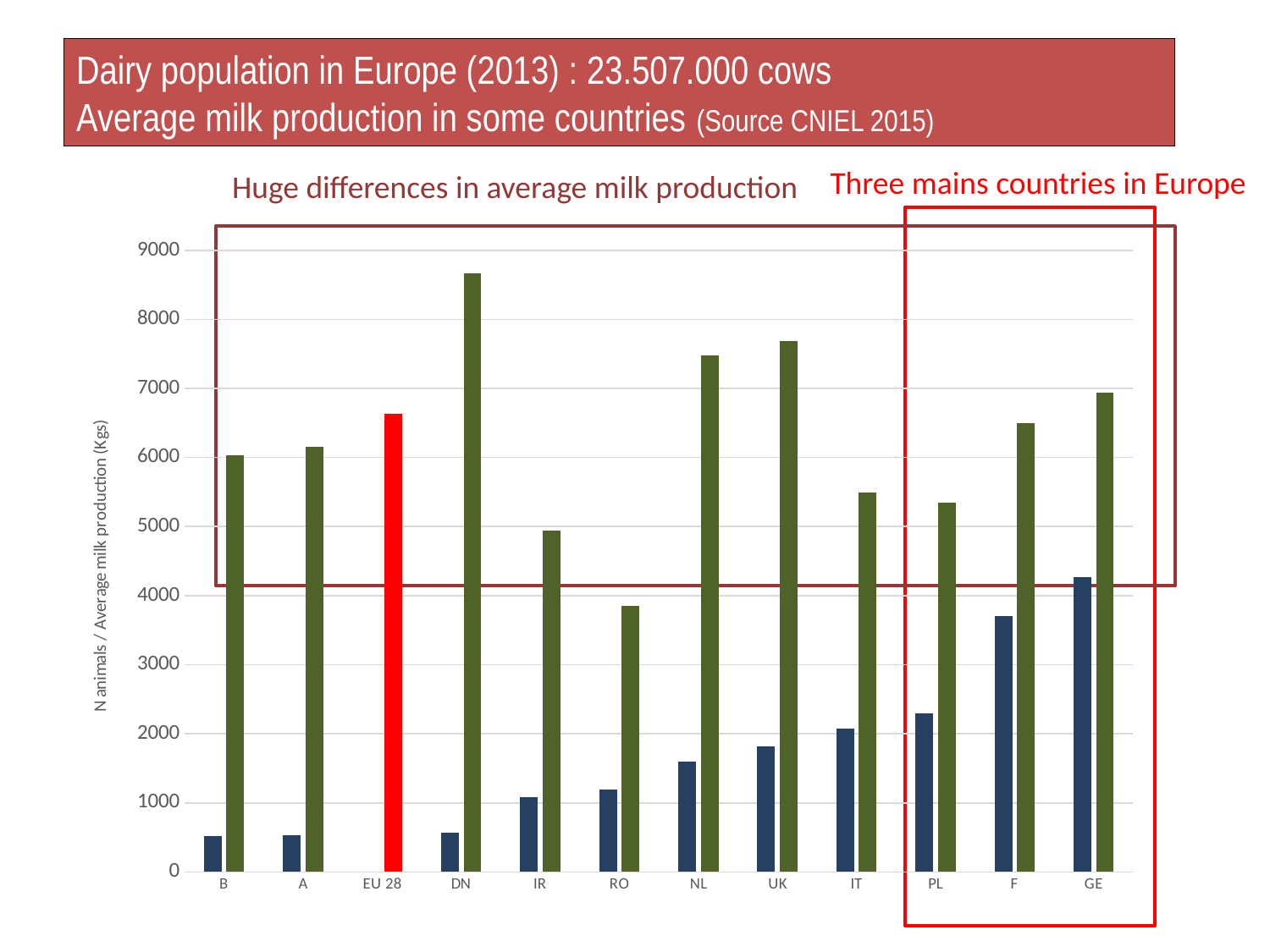
Is the blue bar for GE greater or less than 4000? greater Which category has the tallest blue bar? GE How many countries/categories are shown on the x axis of the chart? 12 Which category is shown with a red bar? EU 28 What is the label of the vertical axis? N animals / Average milk production (Kgs) What kind of chart is shown on the slide? bar chart Which has the taller green bar, F or GE? GE Is the blue bar for B greater or less than 1000? less Is the green bar for RO greater or less than 4000? less Which category has the shortest green bar (lowest average milk production)? RO Which category has the tallest green bar (highest average milk production)? DN